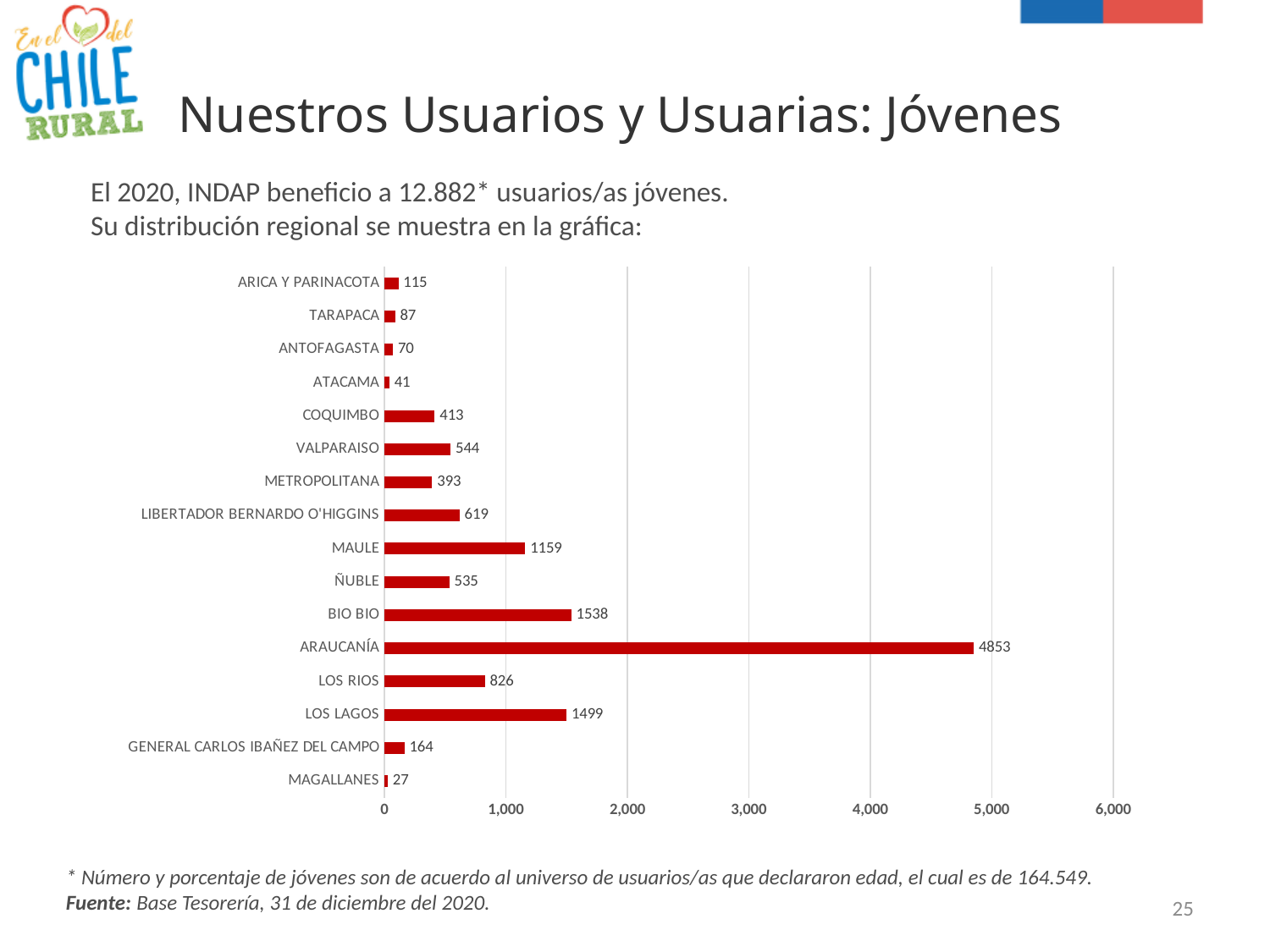
What is the difference between the values for ARAUCANÍA and BIO BIO? 3315 What is the difference between the values for BIO BIO and LOS LAGOS? 39 What kind of chart is shown on the slide? bar chart What is the value for MAGALLANES? 27 Is the value for MAULE greater or less than 1,000? greater What is the value for ARAUCANÍA? 4853 How many regions are shown in the chart? 16 Which is larger, the value for VALPARAISO or the value for ÑUBLE? VALPARAISO What is the value for LOS LAGOS? 1499 Which region has the lowest value? MAGALLANES Which region has the highest value? ARAUCANÍA What colour are the bars in the chart? red